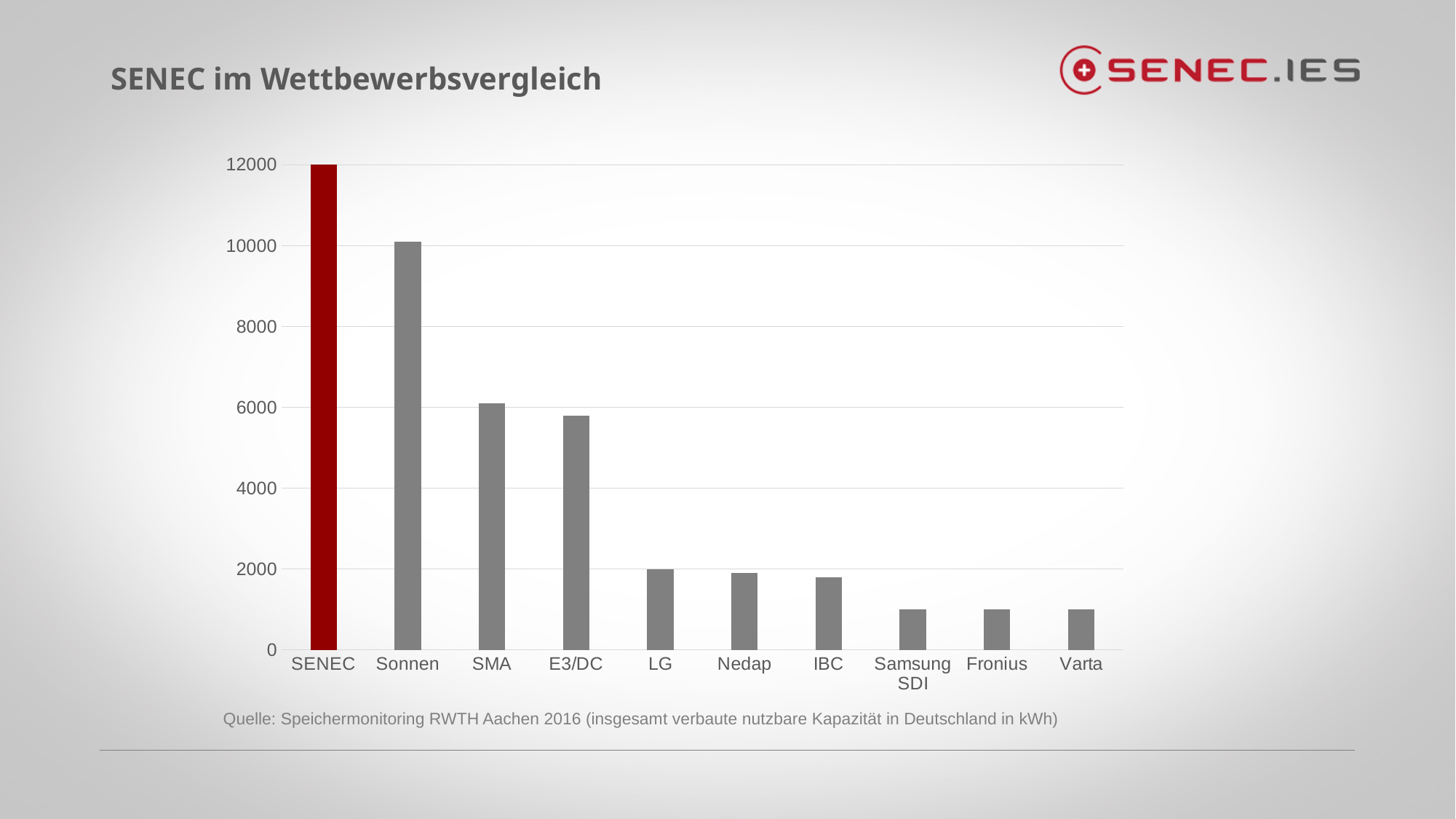
What is the value for LG? 2000 Which is larger, the value for Sonnen or the value for SMA? Sonnen Is the value for SMA greater or less than 4000? greater Do the values rise or fall from left to right along the x axis? fall How many companies are shown on the x axis of the chart? 10 Which company has the highest value in the chart? SENEC What kind of chart is shown on the slide? bar chart Is the value for Sonnen greater or less than 8000? greater Which bar in the chart is coloured red? SENEC Is the value for E3/DC greater or less than 6000? less What is the value for SENEC? 12000